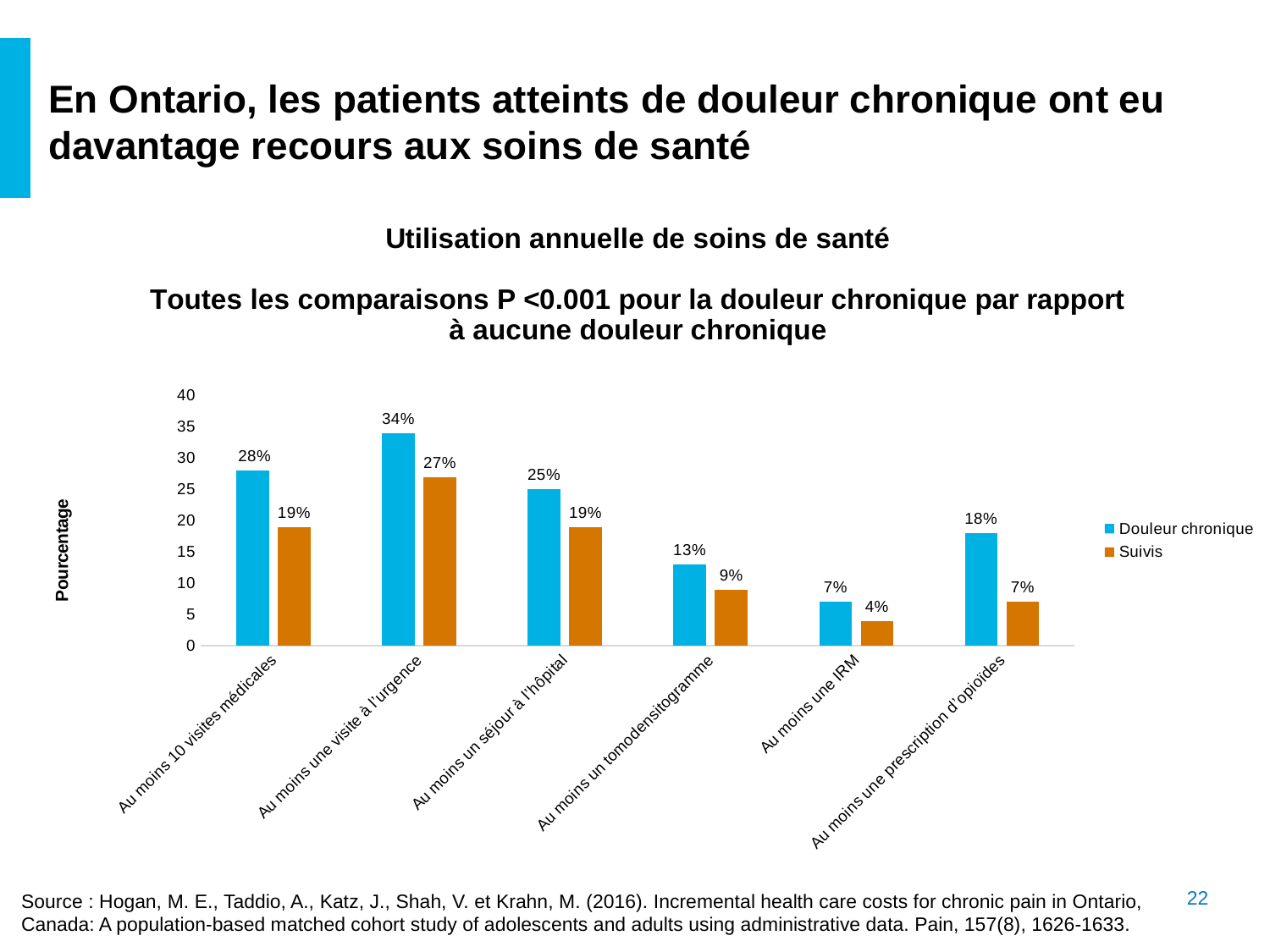
What is the label of the y axis? Pourcentage What is the difference between "Douleur chronique" and "Suivis" for "Au moins une prescription d'opioïdes"? 11% What is the value for "Douleur chronique" for "Au moins une prescription d'opioïdes"? 18% What is the value for "Suivis" for "Au moins une IRM"? 4% What is the difference between "Douleur chronique" and "Suivis" for "Au moins 10 visites médicales"? 9% How many categories are shown on the x axis? 6 What kind of chart is shown on the slide? Bar chart Which is larger: "Douleur chronique" for "Au moins un séjour à l'hôpital" or "Suivis" for "Au moins une visite à l'urgence"? Suivis for Au moins une visite à l'urgence Which category has the highest value for "Douleur chronique"? Au moins une visite à l'urgence What is the value for "Douleur chronique" for "Au moins une visite à l'urgence"? 34% How many series does the legend list? 2 Which category has the lowest value for "Suivis"? Au moins une IRM